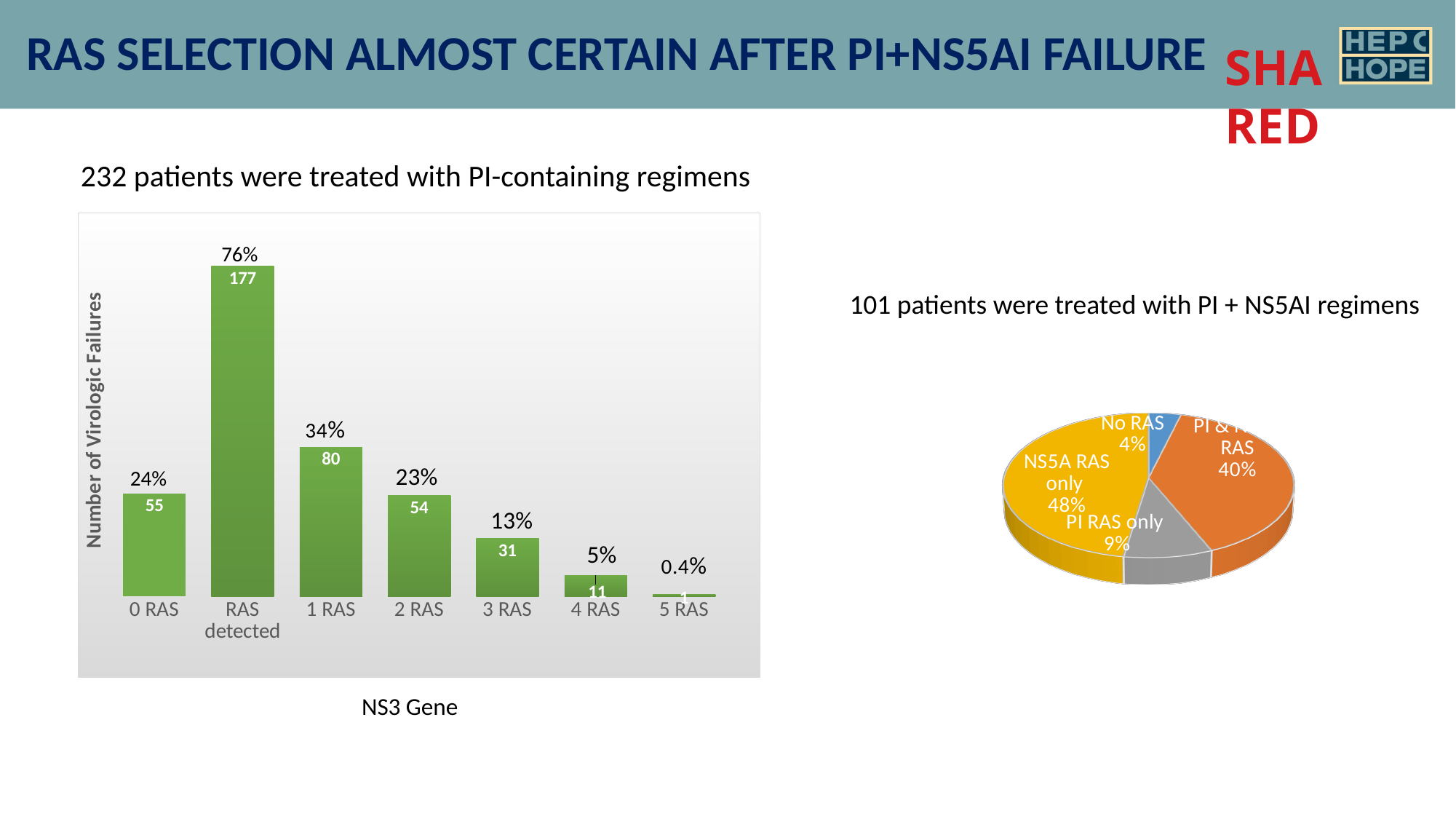
In the bar chart on the left, which has more virologic failures, 0 RAS or 2 RAS? 0 RAS In the pie chart on the right, what share is shown for NS5A RAS only? 48% In the bar chart on the left, how many categories are shown on the x axis? 7 In the bar chart on the left, how many virologic failures are shown for 1 RAS? 80 In the bar chart on the left, which category has the highest number of virologic failures? RAS detected In the bar chart on the left, what is the difference in virologic failures between 1 RAS and 2 RAS? 26 In the pie chart on the right, what share is shown for No RAS? 4% In the bar chart on the left, which category has the lowest number of virologic failures? 5 RAS In the bar chart on the left, how many virologic failures are shown for 0 RAS? 55 In the bar chart on the left, what kind of chart is it? bar chart In the bar chart on the left, what percentage is shown for 3 RAS? 13% In the bar chart on the left, what percentage is shown above the RAS detected bar? 76%